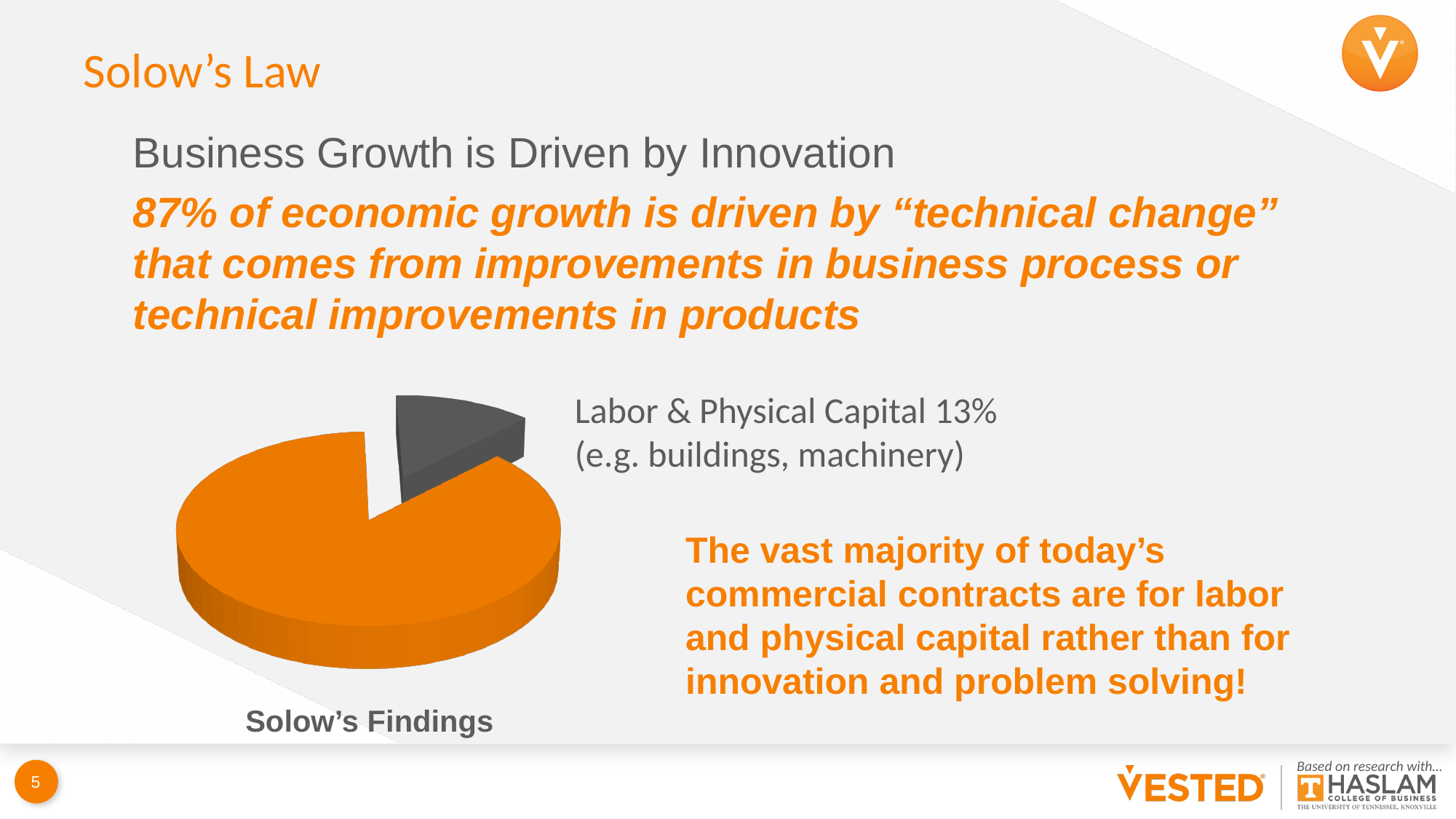
Which slice of the pie chart is the smallest? Labor & Physical Capital Is the Labor & Physical Capital slice greater or less than 50% of the pie? less Which is larger in the pie chart, the orange slice or the gray slice? the orange slice What share of the pie does the Labor & Physical Capital slice represent? 13% What colour is the Labor & Physical Capital slice in the pie chart? gray What percentage of economic growth does the slide attribute to technical change? 87% What percentage does the pie chart attribute to Labor & Physical Capital? 13% Which slice of the pie chart is the largest? technical change (87%) What is the title shown beneath the pie chart? Solow's Findings What kind of chart is shown on the slide? pie chart What is the difference in percentage points between the technical change share and the Labor & Physical Capital share? 74% How many slices does the pie chart have? 2